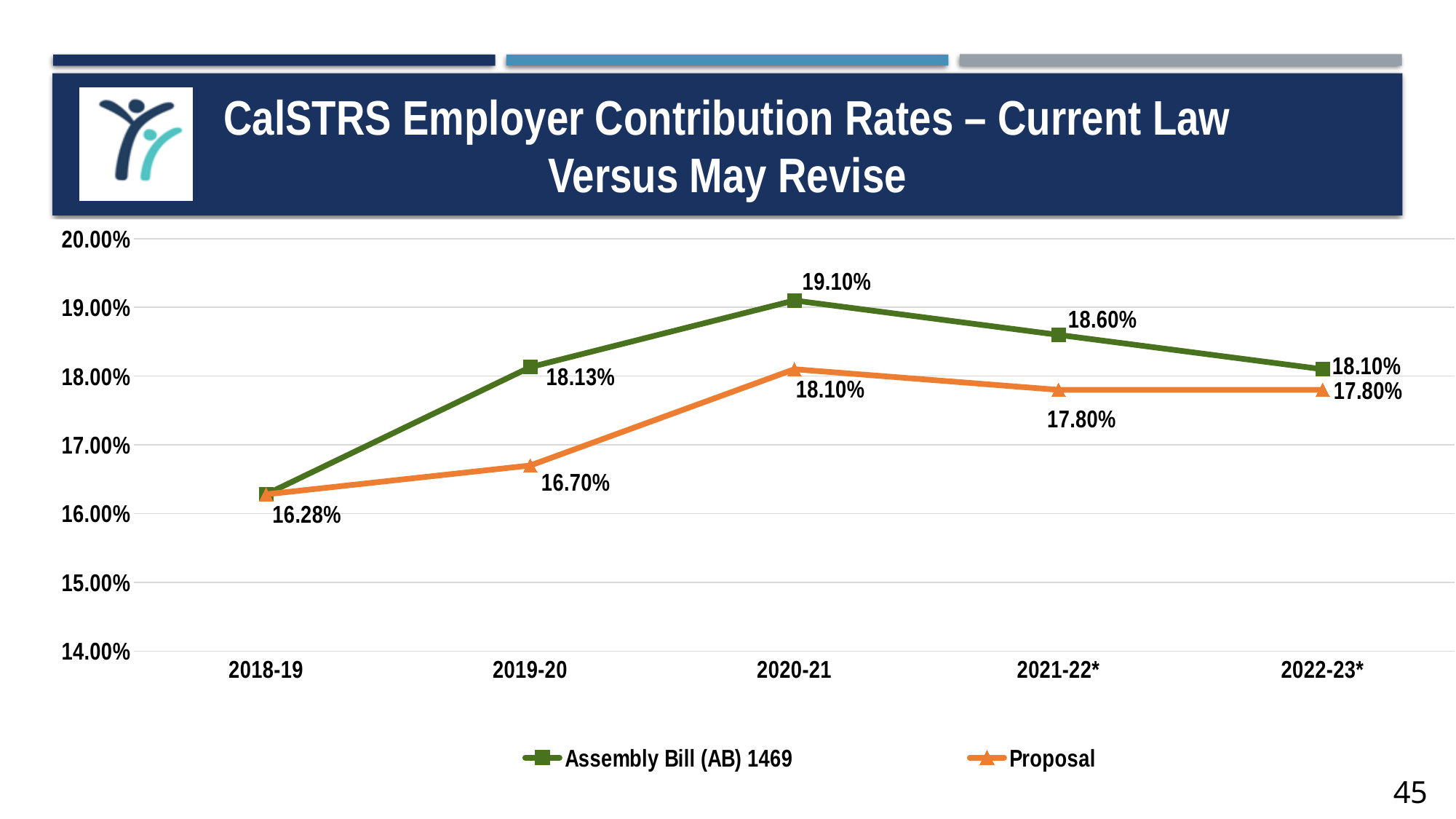
In which year does the Assembly Bill (AB) 1469 series reach its highest value? 2020-21 What is the Proposal rate for 2021-22*? 17.80% Which series has the higher value in 2019-20, Assembly Bill (AB) 1469 or Proposal? Assembly Bill (AB) 1469 What is the Assembly Bill (AB) 1469 rate for 2022-23*? 18.10% What type of chart is shown on the slide? line chart What is the title of the chart on the slide? CalSTRS Employer Contribution Rates – Current Law Versus May Revise What is the difference between the Assembly Bill (AB) 1469 rate and the Proposal rate in 2020-21? 1.00% How many fiscal years are shown on the x axis? 5 How many series does the legend list? 2 What is the Assembly Bill (AB) 1469 rate for 2020-21? 19.10% What is the Proposal rate for 2019-20? 16.70% Does the Assembly Bill (AB) 1469 series rise or fall from 2020-21 to 2022-23*? fall